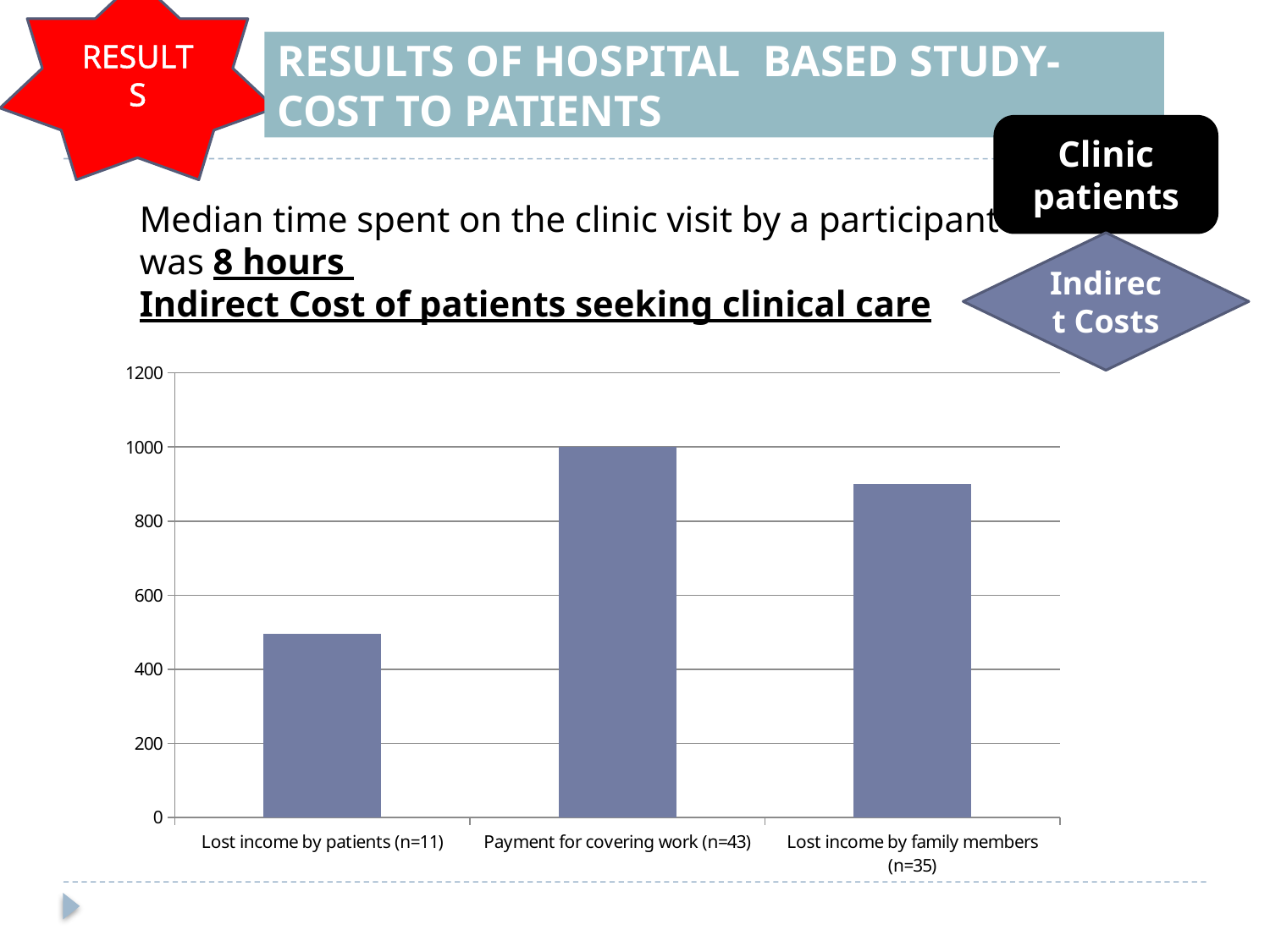
Is the value for Lost income by family members (n=35) greater or less than 1000? less What type of chart is shown on the slide? bar chart Is the value for Lost income by patients (n=11) greater or less than 400? greater Is the value for Lost income by family members (n=35) greater or less than 800? greater What is the maximum value shown on the vertical axis of the chart? 1200 Which is larger: the value for Payment for covering work (n=43) or the value for Lost income by family members (n=35)? Payment for covering work (n=43) Which is larger: the value for Lost income by patients (n=11) or the value for Lost income by family members (n=35)? Lost income by family members (n=35) What is the value for Payment for covering work (n=43)? 1000 Which category has the highest value? Payment for covering work (n=43) How many categories are plotted in the bar chart? 3 Which category has the lowest value? Lost income by patients (n=11)